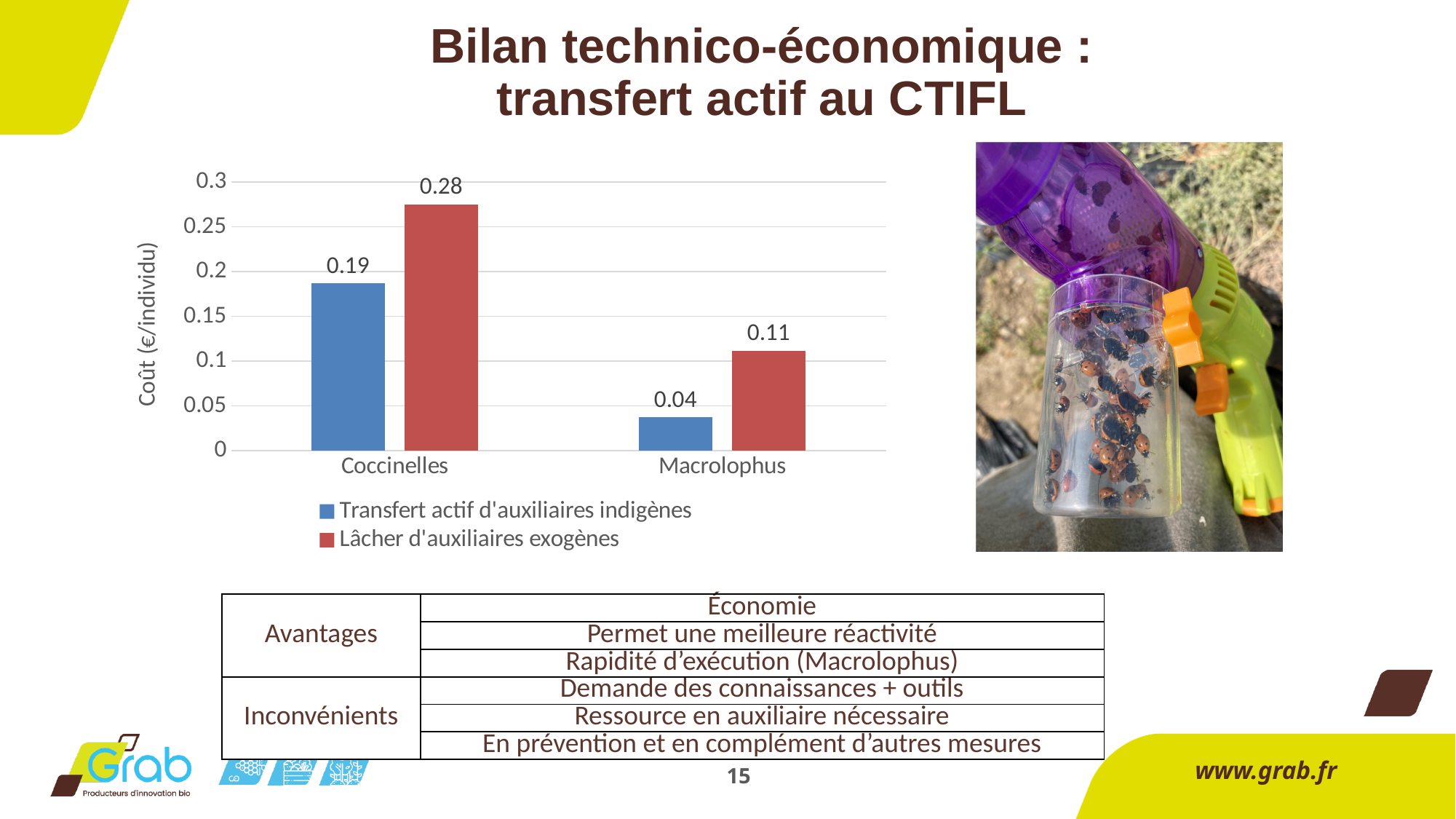
What is the difference between the two series' costs for Coccinelles? 0.09 How many series does the chart legend list? 2 Which category has the highest cost for 'Lâcher d'auxiliaires exogènes'? Coccinelles What is the label of the y axis of the chart? Coût (€/individu) Which category has the lowest cost for 'Transfert actif d'auxiliaires indigènes'? Macrolophus For Macrolophus, which series has the larger cost: 'Transfert actif d'auxiliaires indigènes' or 'Lâcher d'auxiliaires exogènes'? Lâcher d'auxiliaires exogènes What is the cost per individual for Macrolophus under 'Lâcher d'auxiliaires exogènes'? 0.11 What kind of chart is shown on the slide? Bar chart What is the cost per individual for Coccinelles under 'Transfert actif d'auxiliaires indigènes'? 0.19 How many categories are shown on the x axis of the chart? 2 What is the cost per individual for Coccinelles under 'Lâcher d'auxiliaires exogènes'? 0.28 What is the cost per individual for Macrolophus under 'Transfert actif d'auxiliaires indigènes'? 0.04